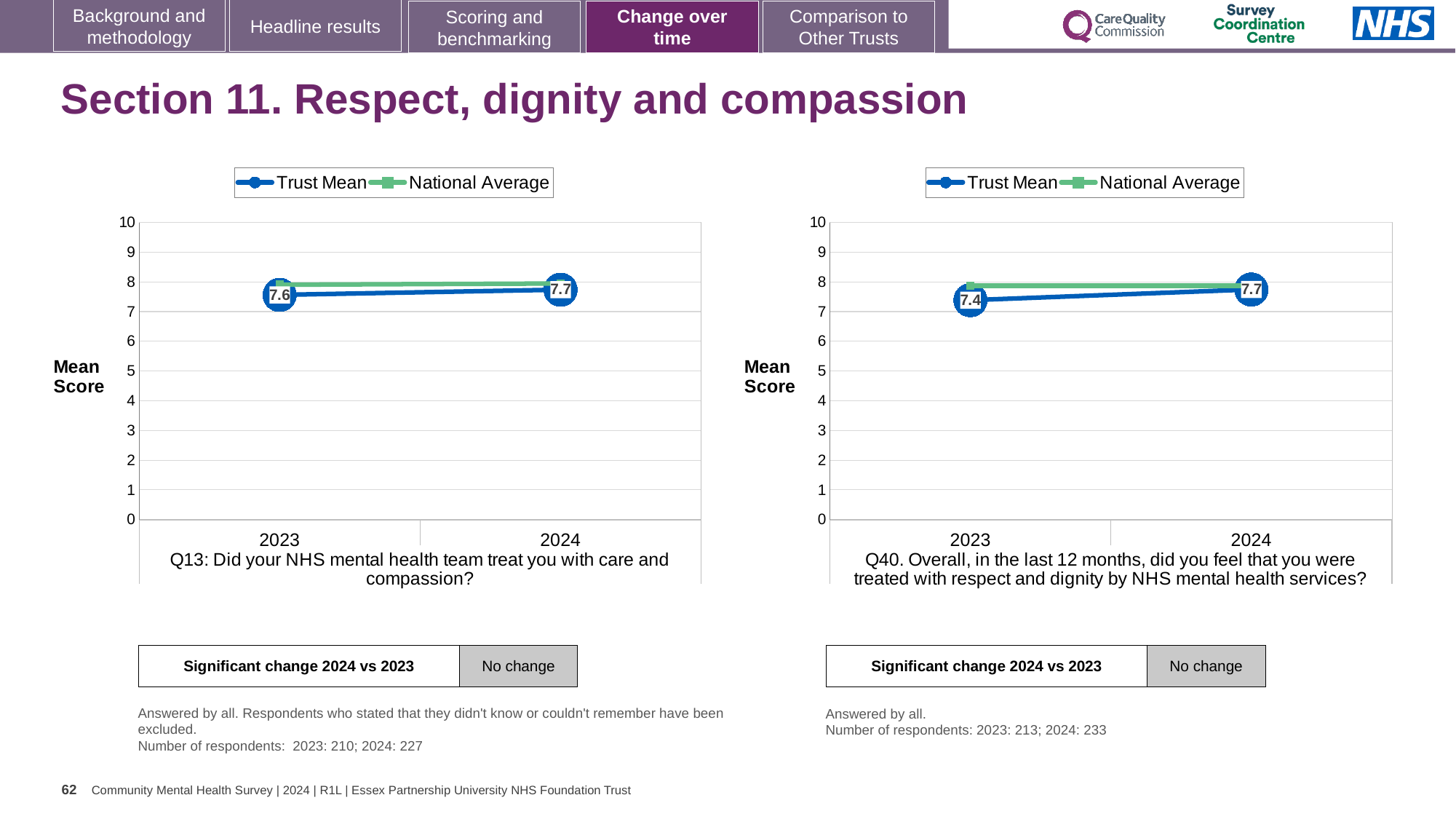
In the Q13 chart (left), what is the Trust Mean for 2024? 7.7 What is the label on the y axis of the Q13 chart (left)? Mean Score In the Q40 chart (right), by how much did the Trust Mean change from 2023 to 2024? 0.3 In the Q13 chart (left), does the Trust Mean rise or fall from 2023 to 2024? rise In the Q13 chart (left), what is the Trust Mean for 2023? 7.6 What type of chart is the Q40 chart (right)? line chart How many years are plotted on the x axis of the Q40 chart (right)? 2 In the Q13 chart (left), which series is shown in green? National Average In the Q40 chart (right), what is the Trust Mean for 2024? 7.7 In the Q40 chart (right), is the National Average for 2023 greater or less than 7? greater How many series does the legend of the Q13 chart (left) list? 2 In the Q40 chart (right), what is the Trust Mean for 2023? 7.4